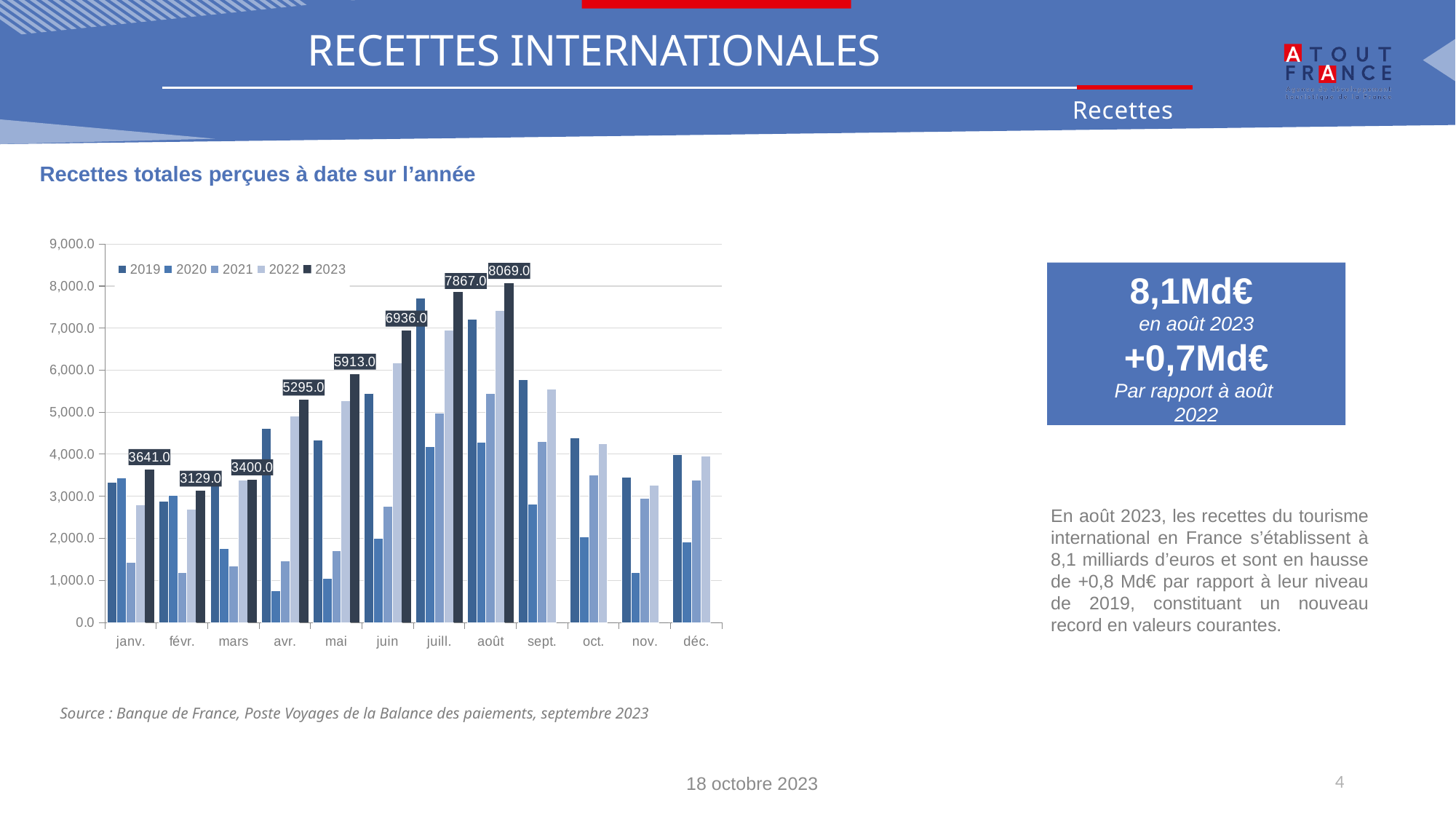
What is the value for 2023 in janv.? 3641.0 What is the value for 2023 in avr.? 5295.0 Is the value for 2022 in août greater or less than 7,000.0? greater What is the value for 2023 in août? 8069.0 Is the value for 2021 in avr. greater or less than 2,000.0? less How many series does the legend list? 5 What is the difference between the 2023 values for mai and avr.? 618.0 Which month has the lowest value for the 2023 series? févr. What is the difference between the 2023 values for août and juill.? 202.0 Which is larger for 2023: the value for mars or the value for févr.? mars Which month has the highest value for the 2023 series? août Do the 2023 values rise or fall from avr. to août? rise